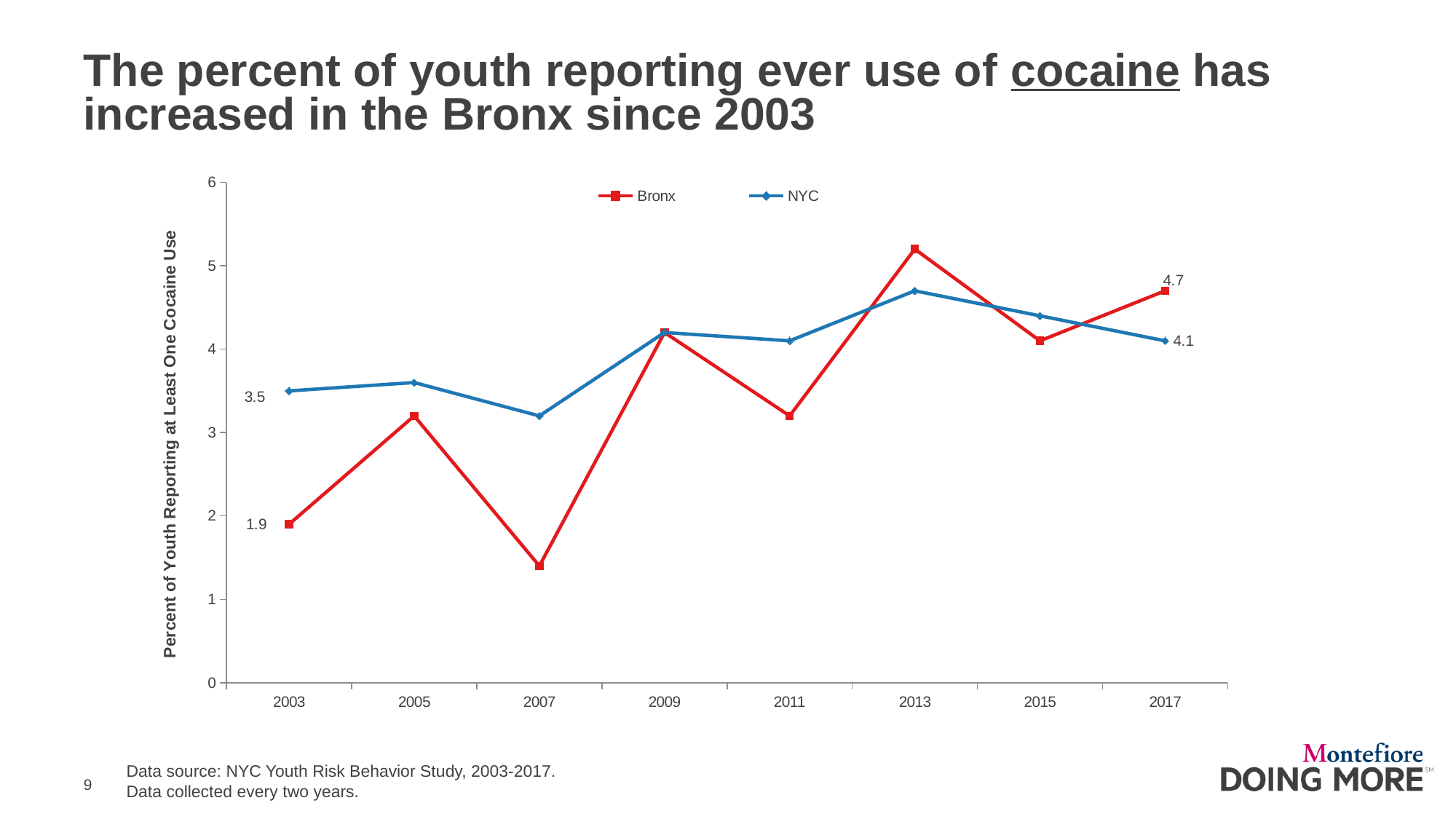
What is the value for NYC in 2017? 4.1 By how much did the Bronx value increase from 2003 to 2017? 2.8 What is the value for NYC in 2003? 3.5 In which year does the Bronx series reach its lowest value? 2007 What is the value for Bronx in 2003? 1.9 What is the value for Bronx in 2017? 4.7 Which series has the higher value in 2003, Bronx or NYC? NYC Is the value for Bronx in 2007 greater or less than 2? less Which series has the higher value in 2017, Bronx or NYC? Bronx In which year does the Bronx series reach its highest value? 2013 How many years are shown on the x axis? 8 What kind of chart is shown on the slide? line chart